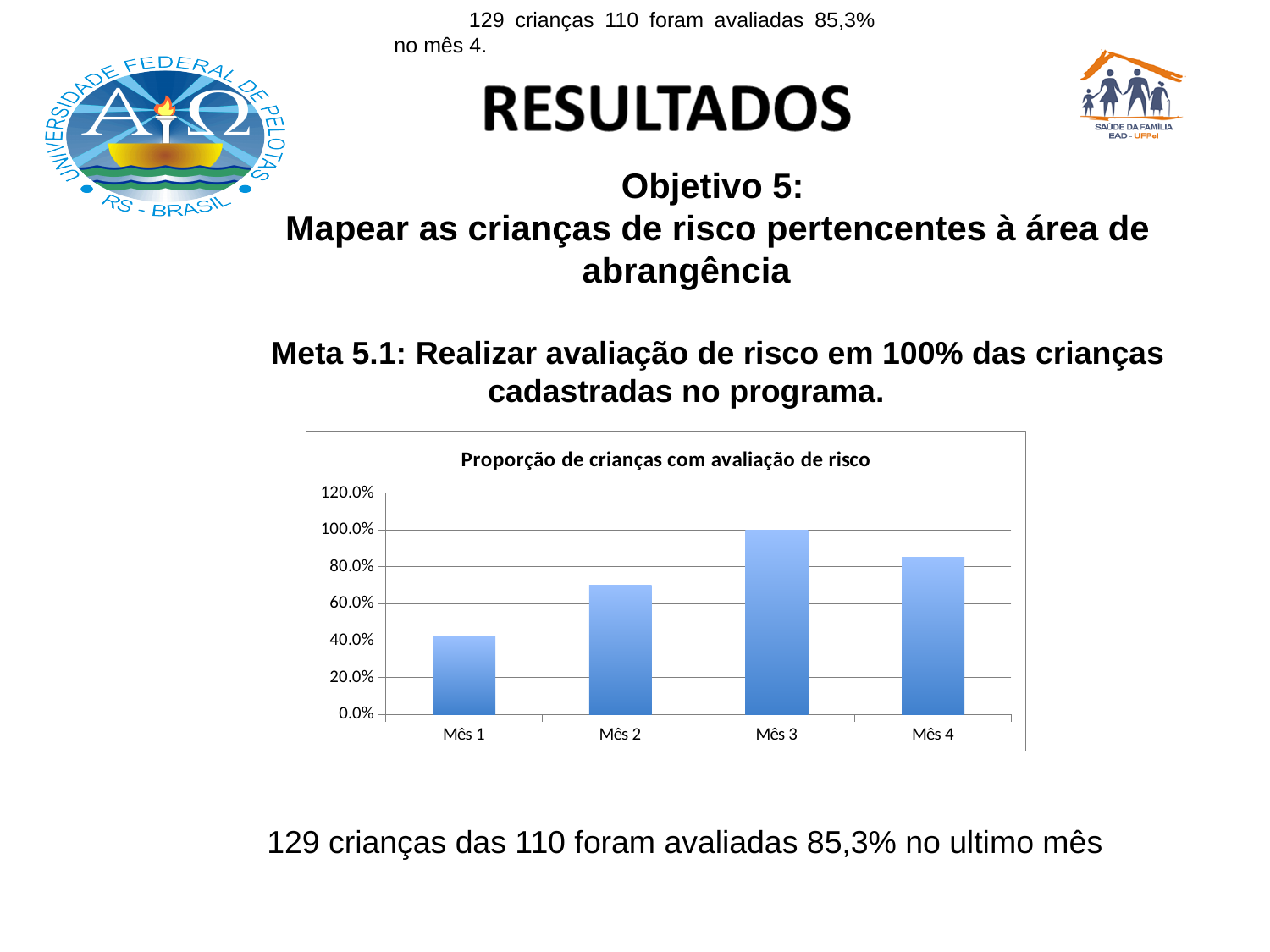
Which month has the highest proportion of children with risk assessment? Mês 3 How many months (categories) are shown on the x axis of the chart? 4 What is the highest tick value shown on the y axis of the chart? 120.0% What kind of chart is shown on the slide? bar chart Is the value for Mês 1 greater or less than 60.0%? less Do the values rise or fall from Mês 1 to Mês 3? rise Is the value for Mês 4 greater or less than 80.0%? greater What is the title of the chart? Proporção de crianças com avaliação de risco Which month has the lowest proportion of children with risk assessment? Mês 1 Which is larger, the value for Mês 2 or the value for Mês 4? Mês 4 Is the value for Mês 2 greater or less than 60.0%? greater What is the value for Mês 3 in the chart? 100.0%